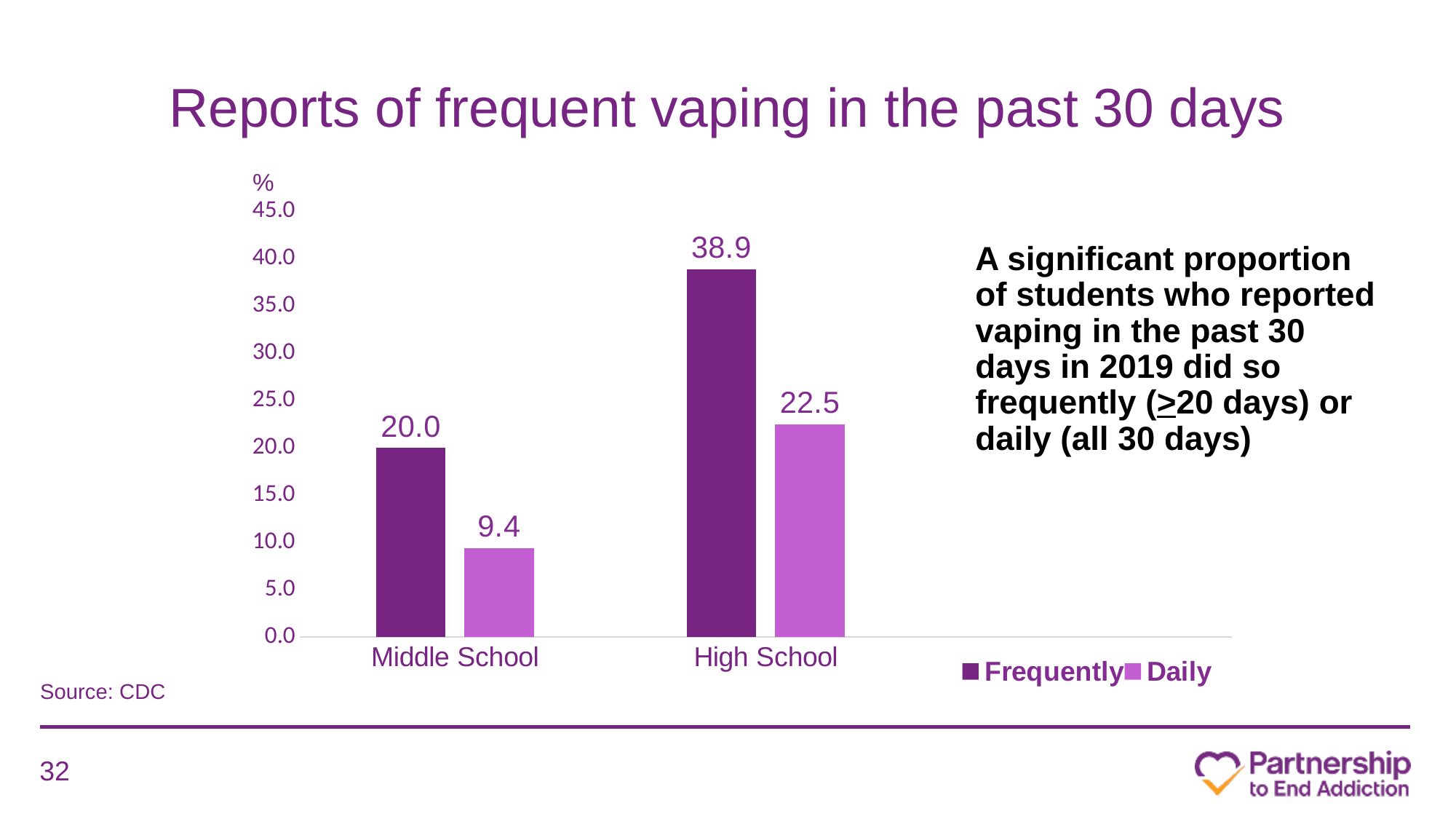
What is the difference between the Frequently values for High School and Middle School? 18.9 What is the difference between the Frequently and Daily values for High School? 16.4 What is the value for Frequently in the High School category? 38.9 Which bar has the lowest value on the chart? Daily, Middle School How many series does the legend list? 2 Which category has the highest Frequently value? High School How many categories are shown on the x axis? 2 What kind of chart is shown on the slide? Bar chart What is the value for Daily in the Middle School category? 9.4 What is the value for Frequently in the Middle School category? 20.0 Which is larger: the Daily value for High School or the Frequently value for Middle School? Daily value for High School What is the value for Daily in the High School category? 22.5